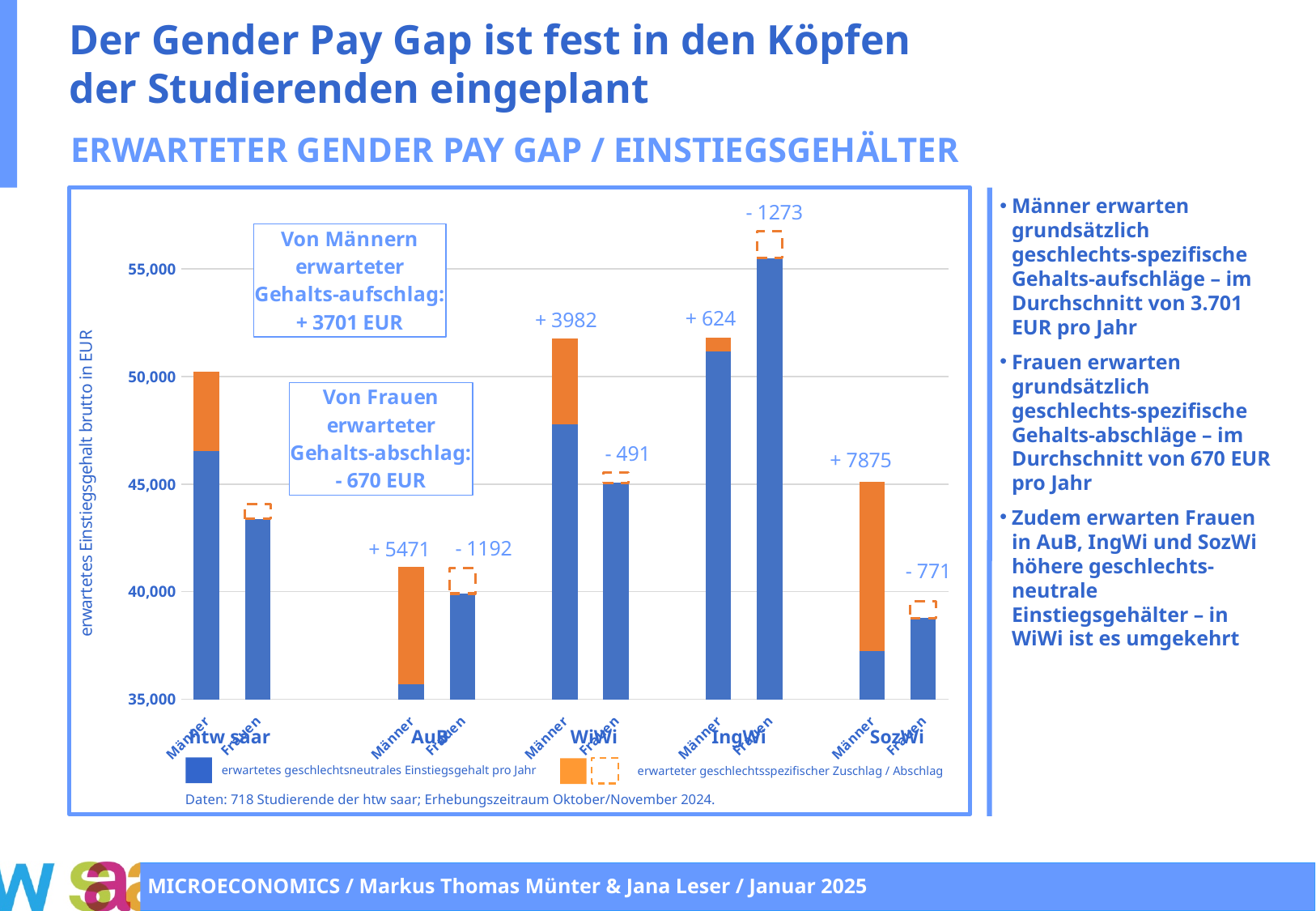
What gender-specific surcharge do men in SozWi expect, according to the data label? + 7875 What is the average surcharge expected by men at htw saar, as shown in the box on the chart? + 3701 EUR Which is larger in magnitude: the discount expected by women in AuB or the discount expected by women in WiWi? AuB In which study area do men expect the smallest gender-specific surcharge? IngWi What kind of chart is shown on the slide? bar chart By how much does the surcharge expected by men in SozWi exceed the surcharge expected by men in AuB? 2404 Is the expected gender-neutral starting salary (blue bar) for men in IngWi greater or less than 50,000? greater What gender-specific surcharge do men in AuB expect, according to the data label? + 5471 What gender-specific discount do women in IngWi expect, according to the data label? - 1273 In which study area do men expect the largest gender-specific surcharge? SozWi How many entries does the chart legend list? 2 How many study-area groups (htw saar, AuB, WiWi, IngWi, SozWi) are shown on the x axis? 5